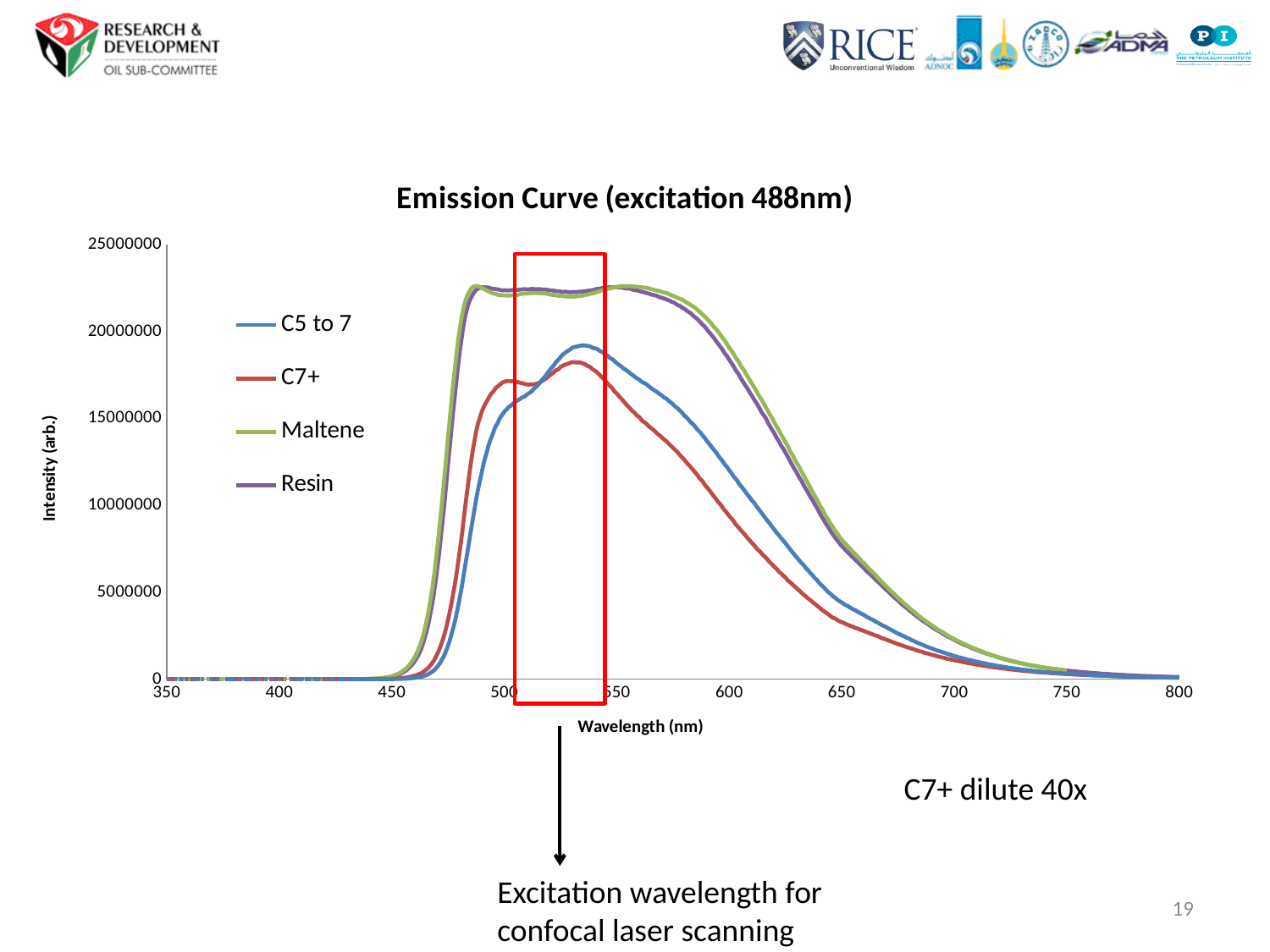
Is the intensity of C5 to 7 at 600 nm greater or less than 10000000? greater At 500 nm, which series has the higher intensity, Resin or C5 to 7? Resin What kind of chart is shown on the slide? line chart What is the label of the x axis of the chart? Wavelength (nm) Is the intensity of Maltene at 500 nm greater or less than 20000000? greater How many tick labels are shown on the x axis of the chart? 10 Is the intensity of Resin at 450 nm greater or less than 5000000? less Between 600 nm and 700 nm, do the intensity values of the series rise or fall? fall How many series does the legend of the Emission Curve chart list? 4 At 600 nm, which series has the higher intensity, Maltene or C7+? Maltene What is the title of the chart? Emission Curve (excitation 488nm)